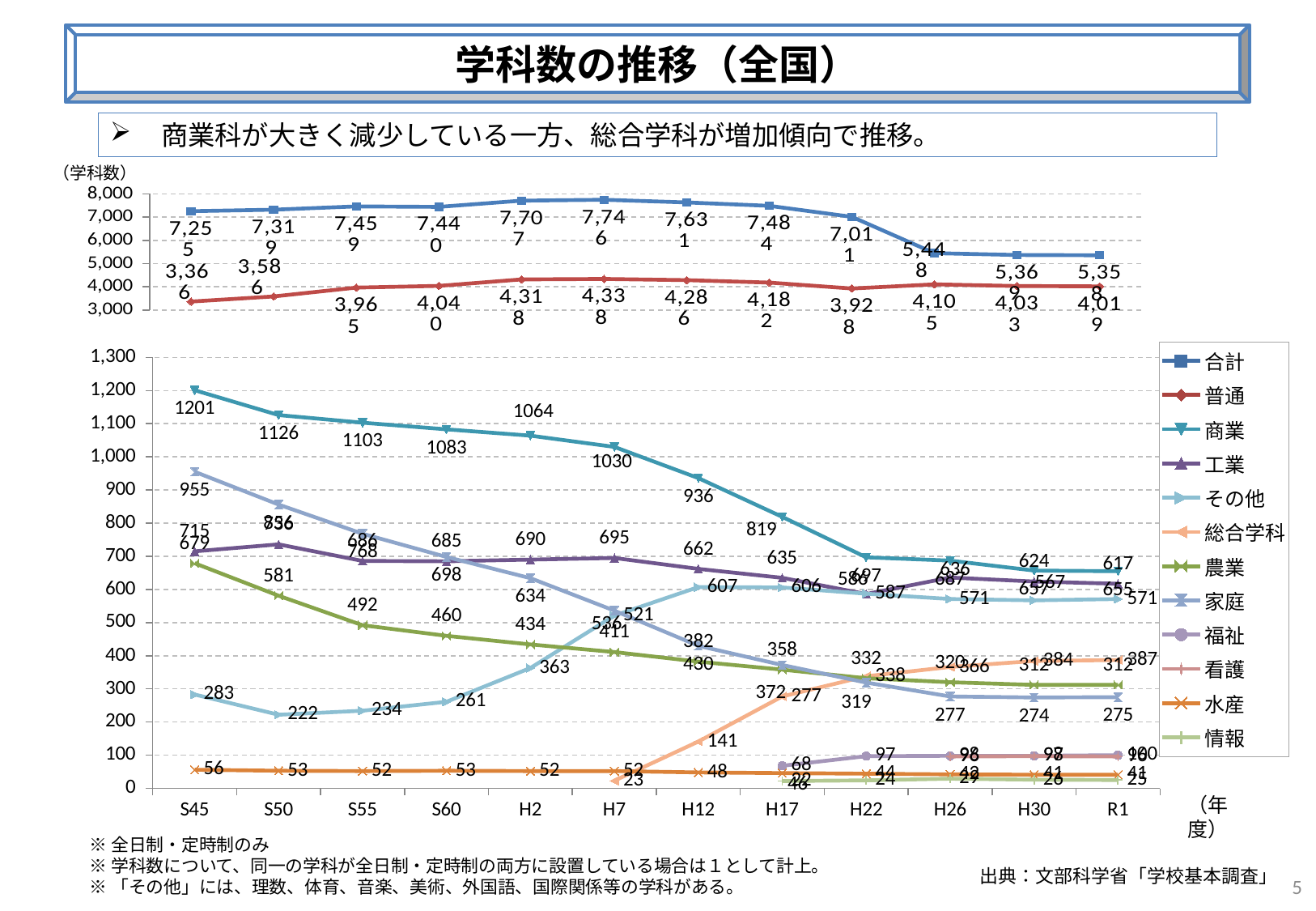
In the top chart, what is the value of 普通 at R1? 4,019 In the bottom chart, what is the value of 商業 at S45? 1201 How many series does the legend of the bottom chart list? 12 In the top chart, at which year is 合計 highest? H7 What kind of chart is the bottom chart? line chart In the bottom chart, what is the value of 総合学科 at H7? 23 How many year categories are shown on the x axis of the bottom chart? 12 In the bottom chart, which is larger at S45, 商業 or 家庭? 商業 In the top chart, what is the value of 合計 at S45? 7,255 In the top chart, what is the difference between 合計 at H22 and 合計 at H26? 1,563 In the bottom chart, what is the value of 商業 at R1? 655 In the bottom chart, does the 商業 series rise or fall from S45 to R1? fall